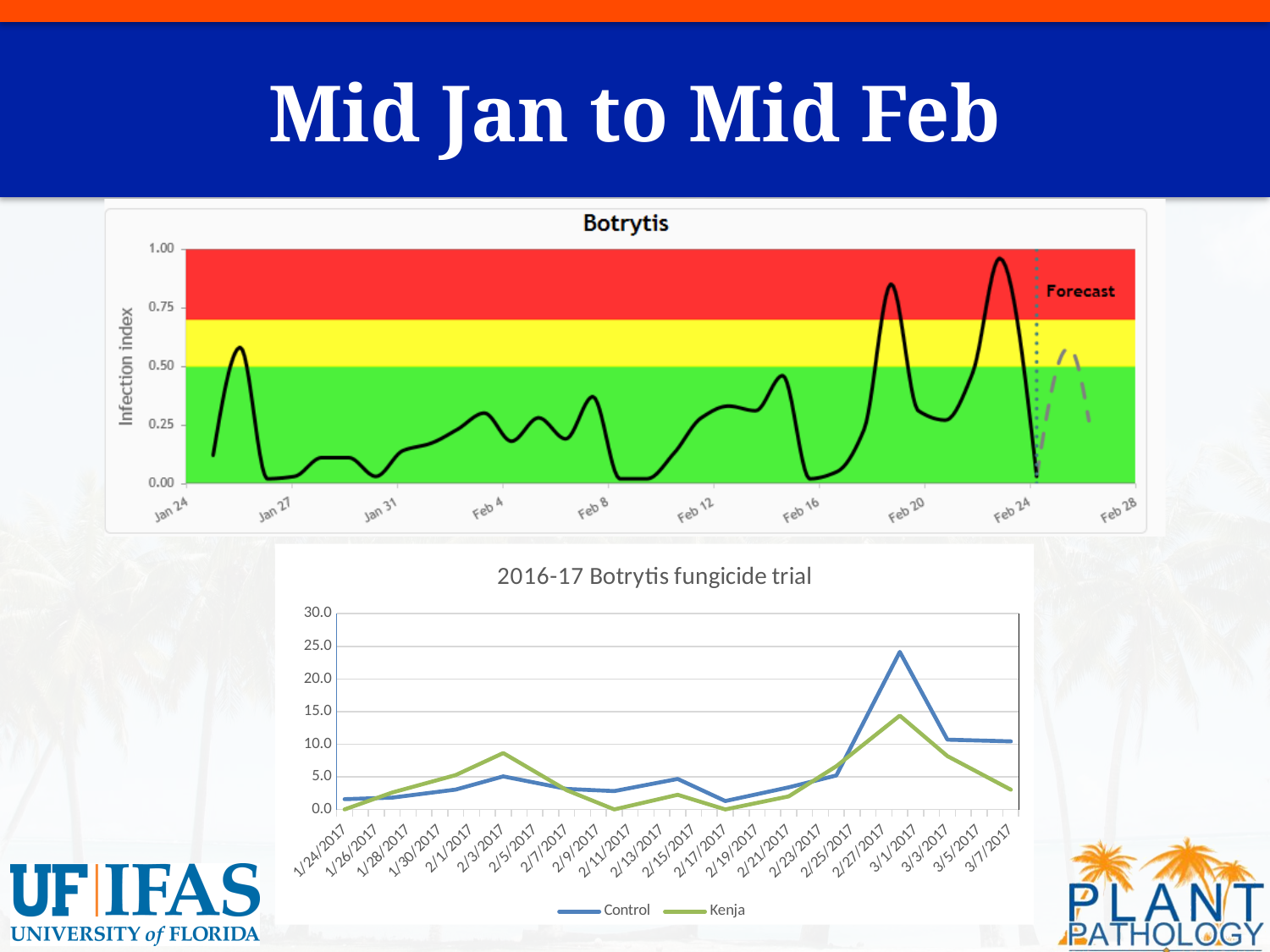
In the '2016-17 Botrytis fungicide trial' chart, is the Kenja value on 3/7/2017 greater or less than 5.0? less In the top 'Botrytis' chart, is the peak infection index value just before Feb 24 greater or less than 0.75? greater In the '2016-17 Botrytis fungicide trial' chart, which series has the larger value on 2/27/2017, Control or Kenja? Control In the '2016-17 Botrytis fungicide trial' chart, which series has the larger value on 2/3/2017, Control or Kenja? Kenja In the '2016-17 Botrytis fungicide trial' chart, which series is shown in blue? Control In the top 'Botrytis' chart, what does the dashed grey line to the right of the dotted vertical line represent? Forecast What type of chart is the bottom chart titled '2016-17 Botrytis fungicide trial'? line chart What is the title of the top chart? Botrytis In the '2016-17 Botrytis fungicide trial' chart, is the Kenja value on 2/27/2017 greater or less than 10.0? greater How many series does the legend of the '2016-17 Botrytis fungicide trial' chart list? 2